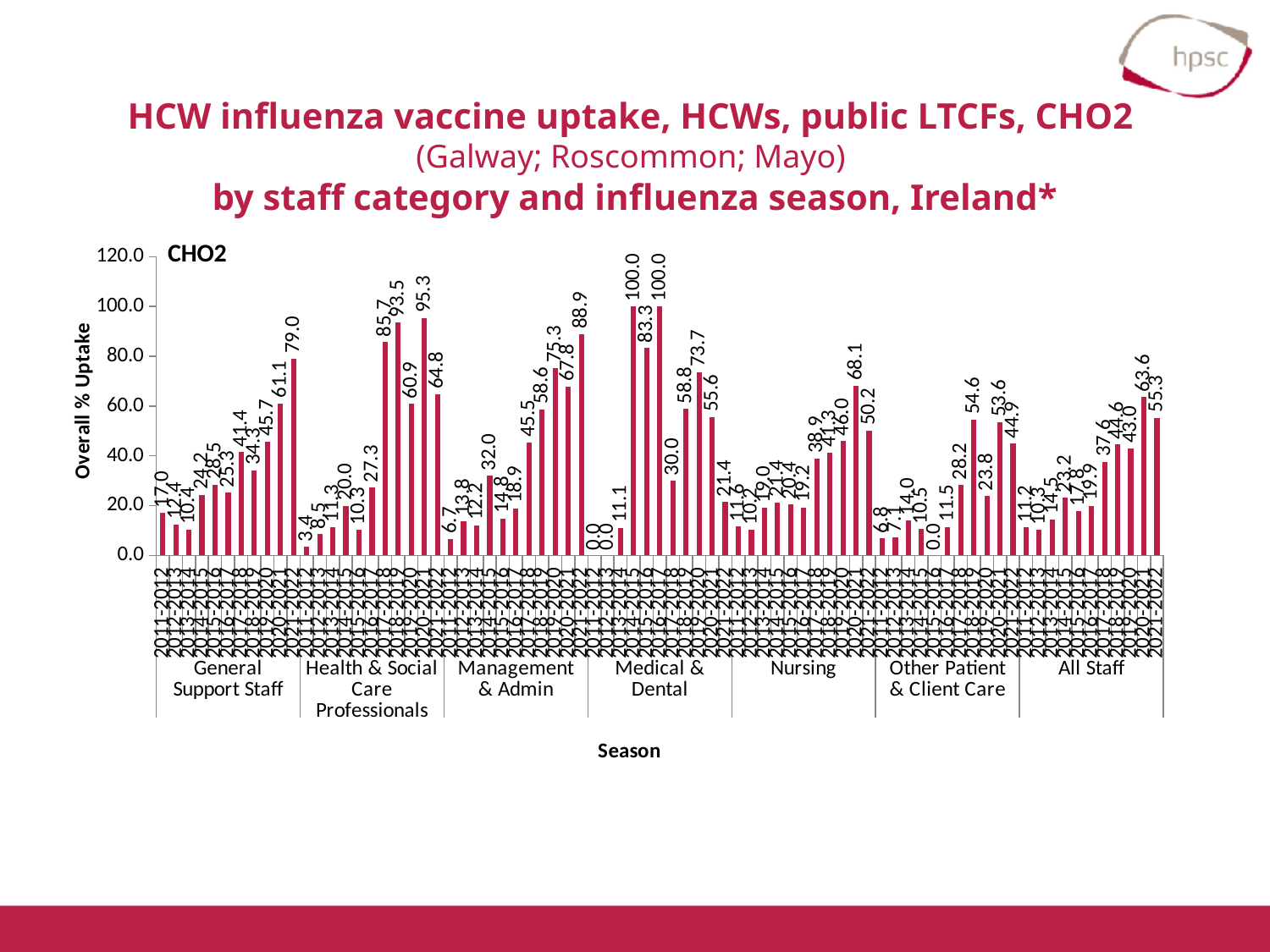
What is the highest value shown for the Medical & Dental category? 100.0 What type of chart is shown on the slide? bar chart What is the lowest value shown for the Health & Social Care Professionals category? 3.4 What is the overall % uptake for All Staff in the 2021-2022 season? 55.3 Which is larger: the 2021-2022 value for Nursing or the 2021-2022 value for Other Patient & Client Care? Nursing What is the overall % uptake for General Support Staff in the 2021-2022 season? 79.0 What is the label on the y axis of the chart? Overall % Uptake Which season has the highest uptake in the All Staff category? 2020-2021 How many staff categories are shown along the x axis of the chart? 7 Is the 2021-2022 value for Management & Admin greater or less than 80.0? greater What is the highest value shown for the Management & Admin category? 88.9 What is the difference between the General Support Staff values for 2021-2022 (79.0) and 2020-2021 (61.1)? 17.9